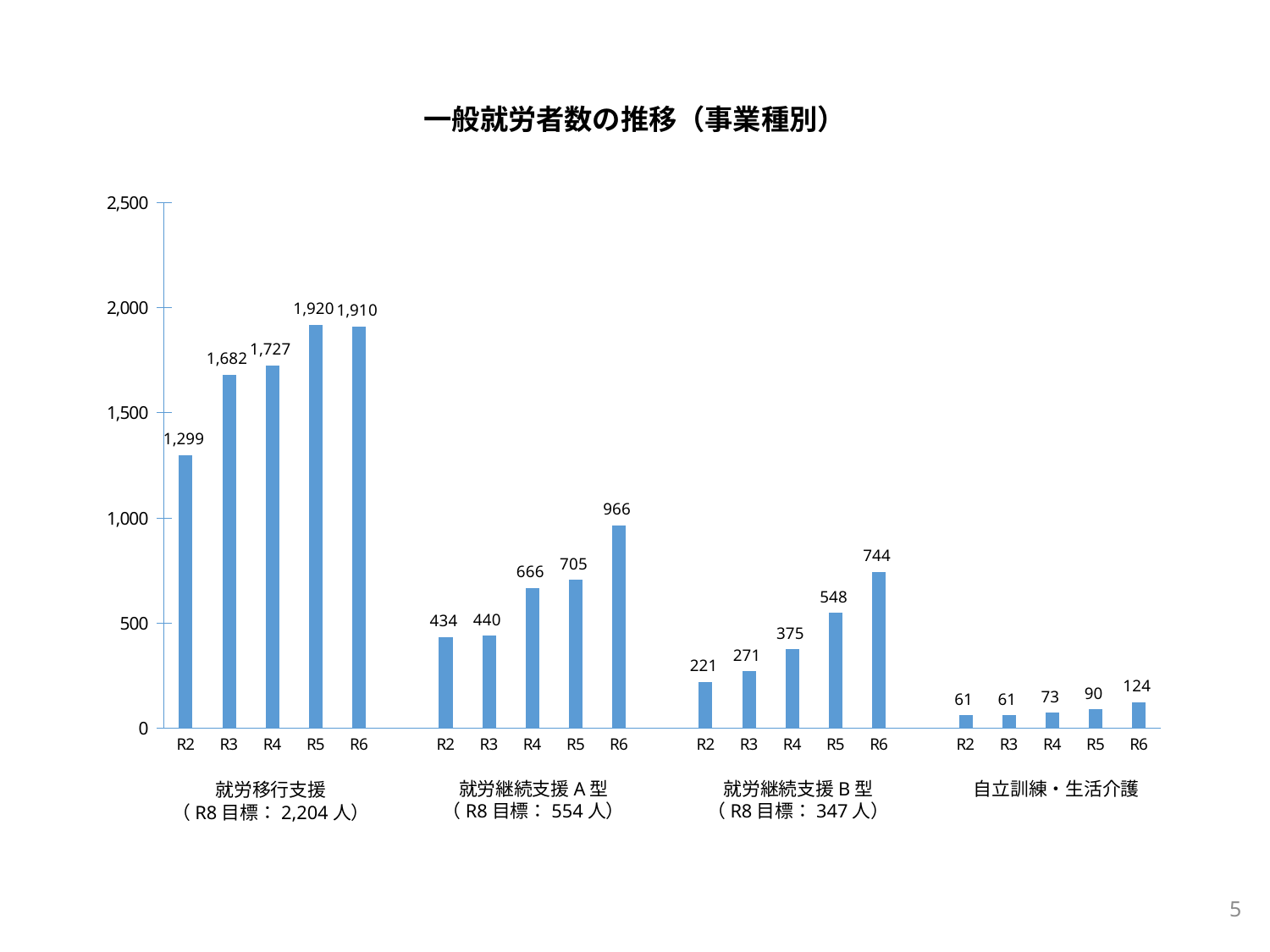
What kind of chart is shown on the slide? Bar chart Which year has the highest value in the 就労移行支援 group? R5 What is the difference between the R6 and R2 values in the 自立訓練・生活介護 group? 63 How many bars are plotted in the 就労継続支援B型 group? 5 What is the value for R5 in the 就労継続支援B型 group? 548 What is the value for R6 in the 就労継続支援A型 group? 966 What is the title of the chart? 一般就労者数の推移（事業種別） Is the R4 value for 就労継続支援A型 greater or less than 500? greater Which is larger: the R6 value for 就労継続支援A型 or the R6 value for 就労継続支援B型? 就労継続支援A型 What is the value for R2 in the 就労移行支援 group? 1,299 What is the difference between the R5 and R6 values in the 就労移行支援 group? 10 Which year has the lowest value in the 就労継続支援B型 group? R2